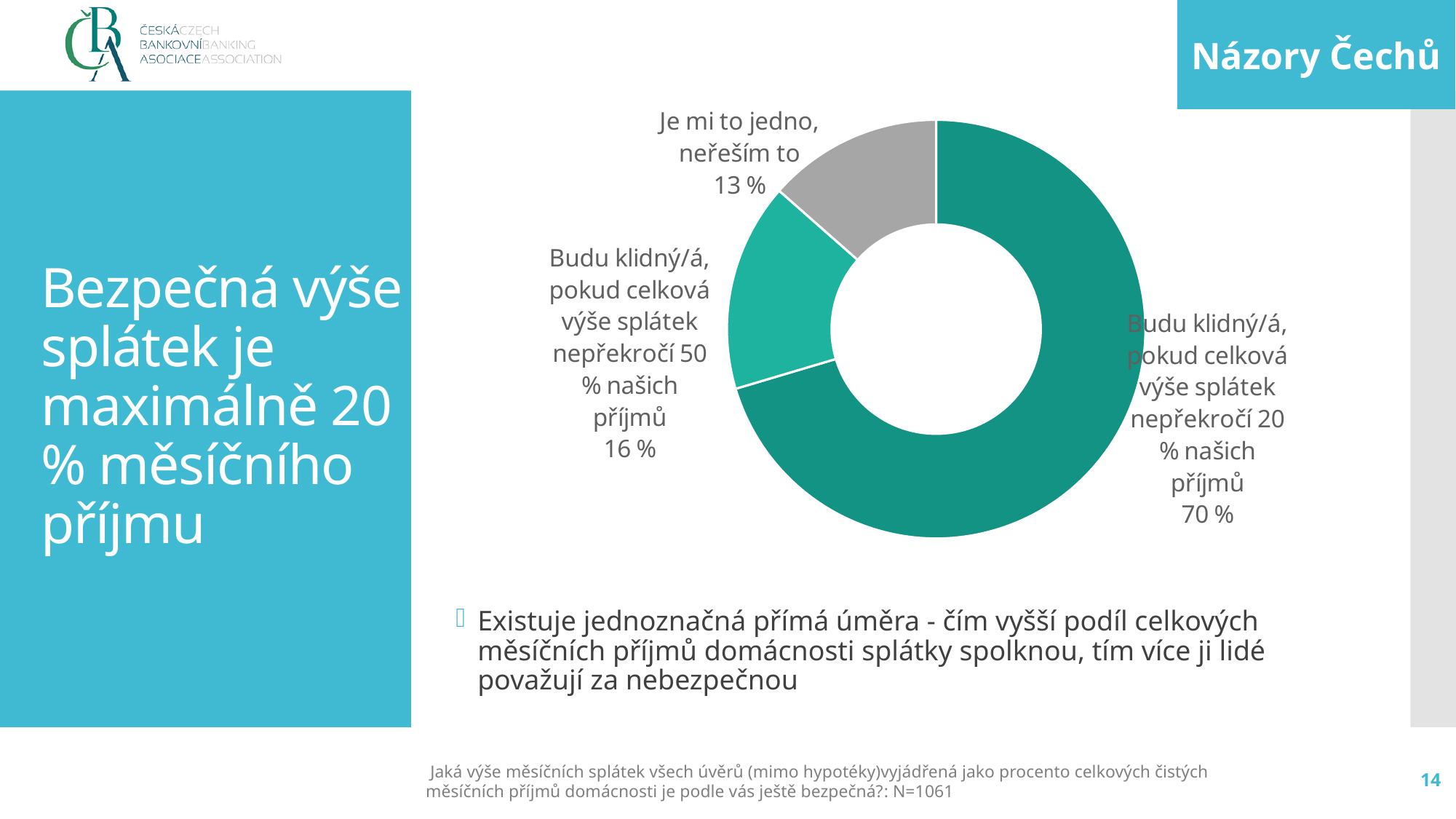
Which response has the smallest share of the chart? Je mi to jedno, neřeším to What colour is the slice for "Je mi to jedno, neřeším to"? Grey What is the sample size (N) stated in the footnote under the chart? N=1061 What percentage of respondents said they would be calm if total repayments do not exceed 20 % of their income? 70 % How many response categories are shown in the chart? 3 How many percentage points separate the 20 % threshold response (70 %) from the 50 % threshold response (16 %)? 54 What is the difference in percentage points between the 50 % threshold response and the "Je mi to jedno, neřeším to" response? 3 Which response has the largest share of the chart? Budu klidný/á, pokud celková výše splátek nepřekročí 20 % našich příjmů Which is larger: the share for the 50 % threshold response or the share for "Je mi to jedno, neřeším to"? The 50 % threshold response (16 %) What percentage of respondents said they would be calm if total repayments do not exceed 50 % of their income? 16 % What type of chart is shown on the slide? Doughnut (pie) chart What percentage of respondents chose "Je mi to jedno, neřeším to"? 13 %